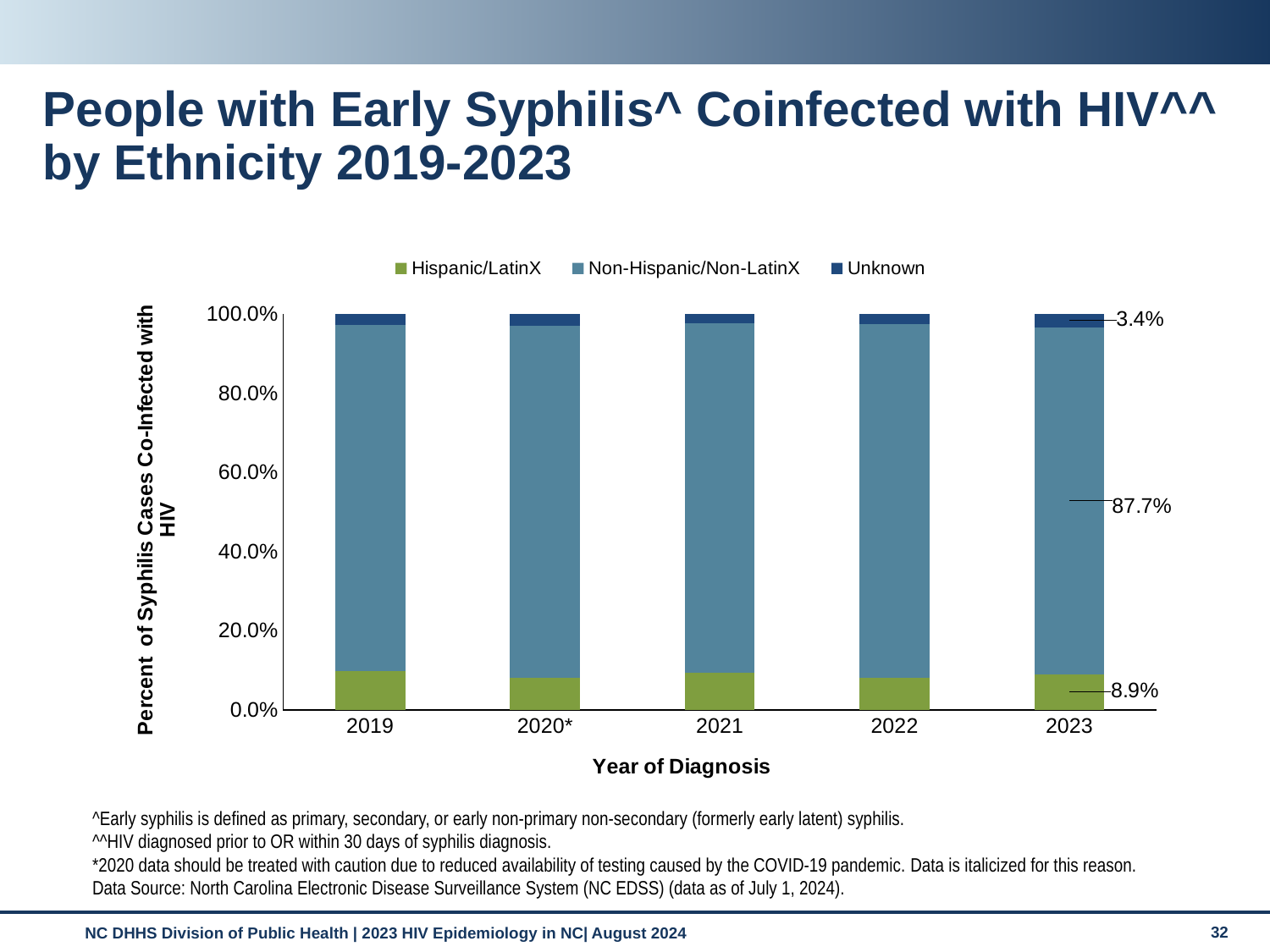
Is the value for Non-Hispanic/Non-LatinX in 2021 greater or less than 80.0%? greater What is the value for Non-Hispanic/Non-LatinX in 2023? 87.7% How many years are shown on the x axis? 5 Is the value for Hispanic/LatinX in 2019 greater or less than 20.0%? less What kind of chart is shown on the slide? Stacked bar chart What is the value for Unknown in 2023? 3.4% How many series does the legend list? 3 What is the label of the x axis? Year of Diagnosis What is the value for Hispanic/LatinX in 2023? 8.9% What is the difference between the Non-Hispanic/Non-LatinX and Hispanic/LatinX values in 2023? 78.8% Which ethnicity group has the smallest share of the 2023 bar? Unknown Which ethnicity group has the largest share of the 2023 bar? Non-Hispanic/Non-LatinX